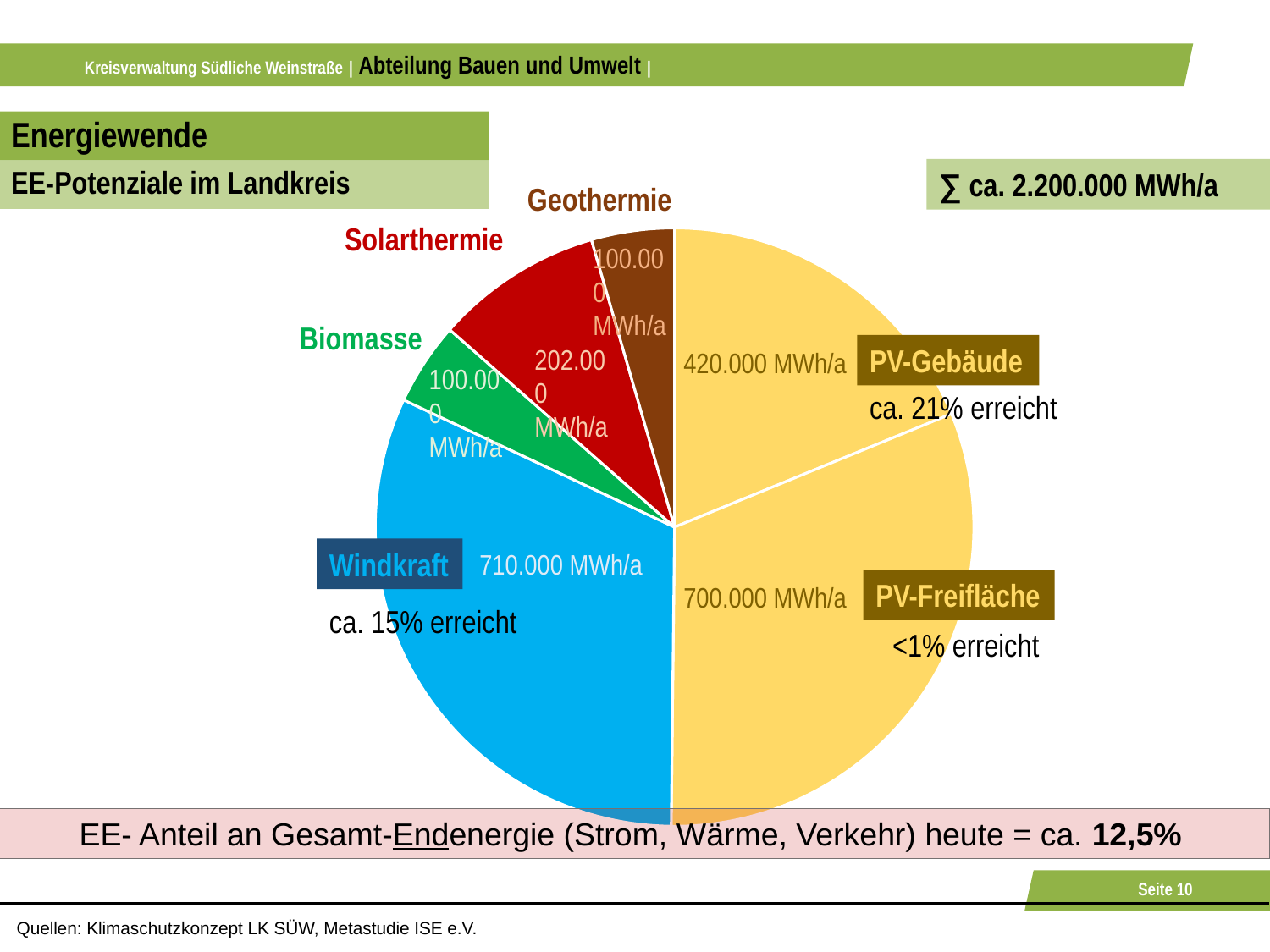
What is the difference between the values for PV-Gebäude and Solarthermie? 218.000 MWh/a How many segments does the pie chart have? 6 What kind of chart is shown on the slide? Pie chart What is the value shown for Windkraft in the pie chart? 710.000 MWh/a Which is larger in the pie chart, PV-Gebäude or Solarthermie? PV-Gebäude What is the value shown for Solarthermie in the pie chart? 202.000 MWh/a What colour is the Windkraft segment in the pie chart? Blue What is the value shown for Biomasse in the pie chart? 100.000 MWh/a What is the value shown for PV-Freifläche in the pie chart? 700.000 MWh/a What is the value shown for PV-Gebäude in the pie chart? 420.000 MWh/a Which category has the largest value in the pie chart? Windkraft What is the difference between the values for Windkraft and PV-Freifläche? 10.000 MWh/a